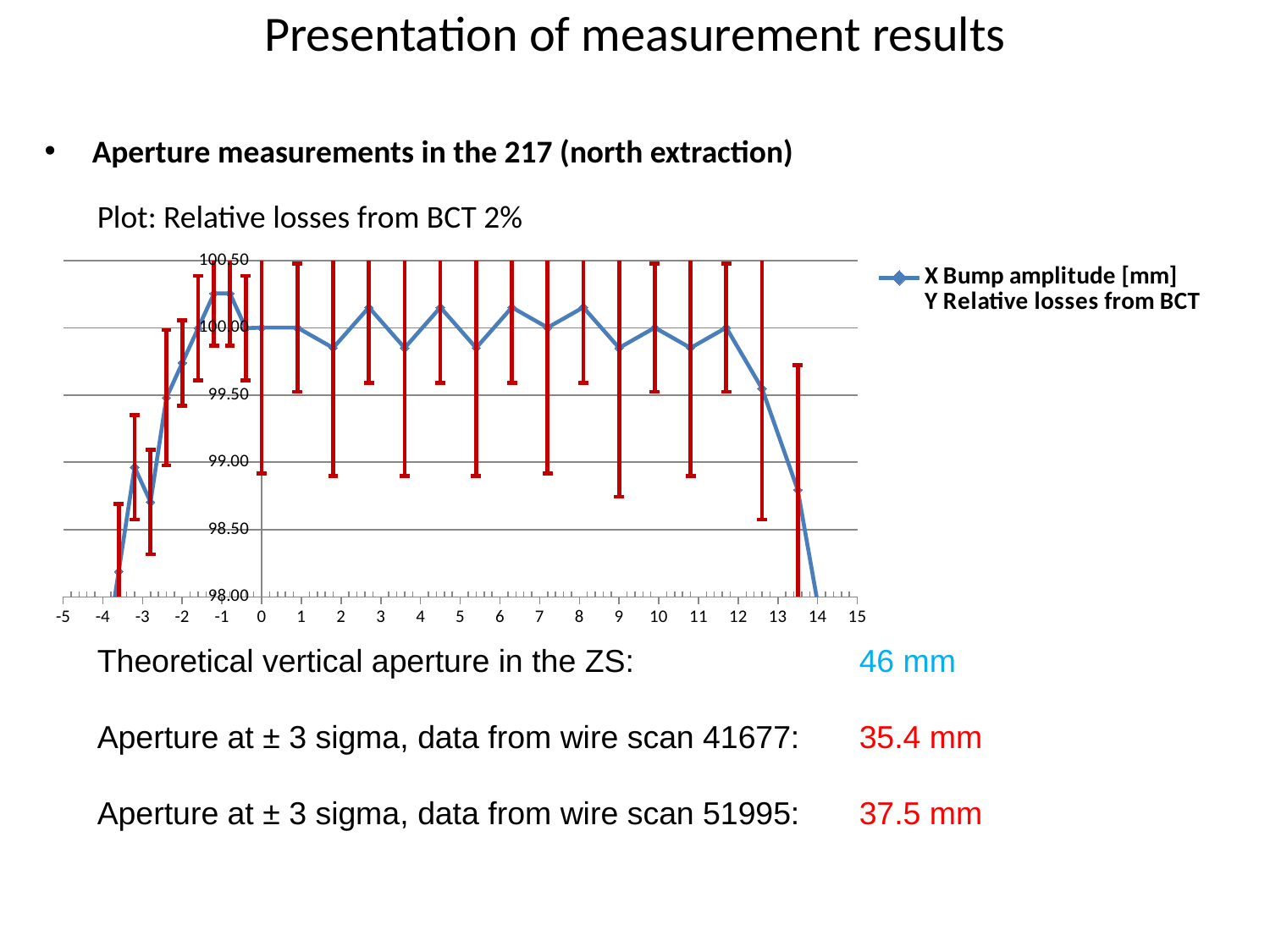
Is the value at x = -1 greater or less than 100.00? greater Is the value of the leftmost point (near x = -4) greater or less than 98.50? less How many series does the chart legend list? 1 Is the value at x = 9 greater or less than 99.50? greater Do the values rise or fall along the x axis between x = -4 and x = -1? rise Do the values rise or fall along the x axis between x = 12 and x = 14? fall What colour are the error bars on the chart? red What kind of chart is shown on the slide? line chart What is the legend entry for the plotted series? X Bump amplitude [mm] Y Relative losses from BCT Around which x value does the line reach its highest point? -1